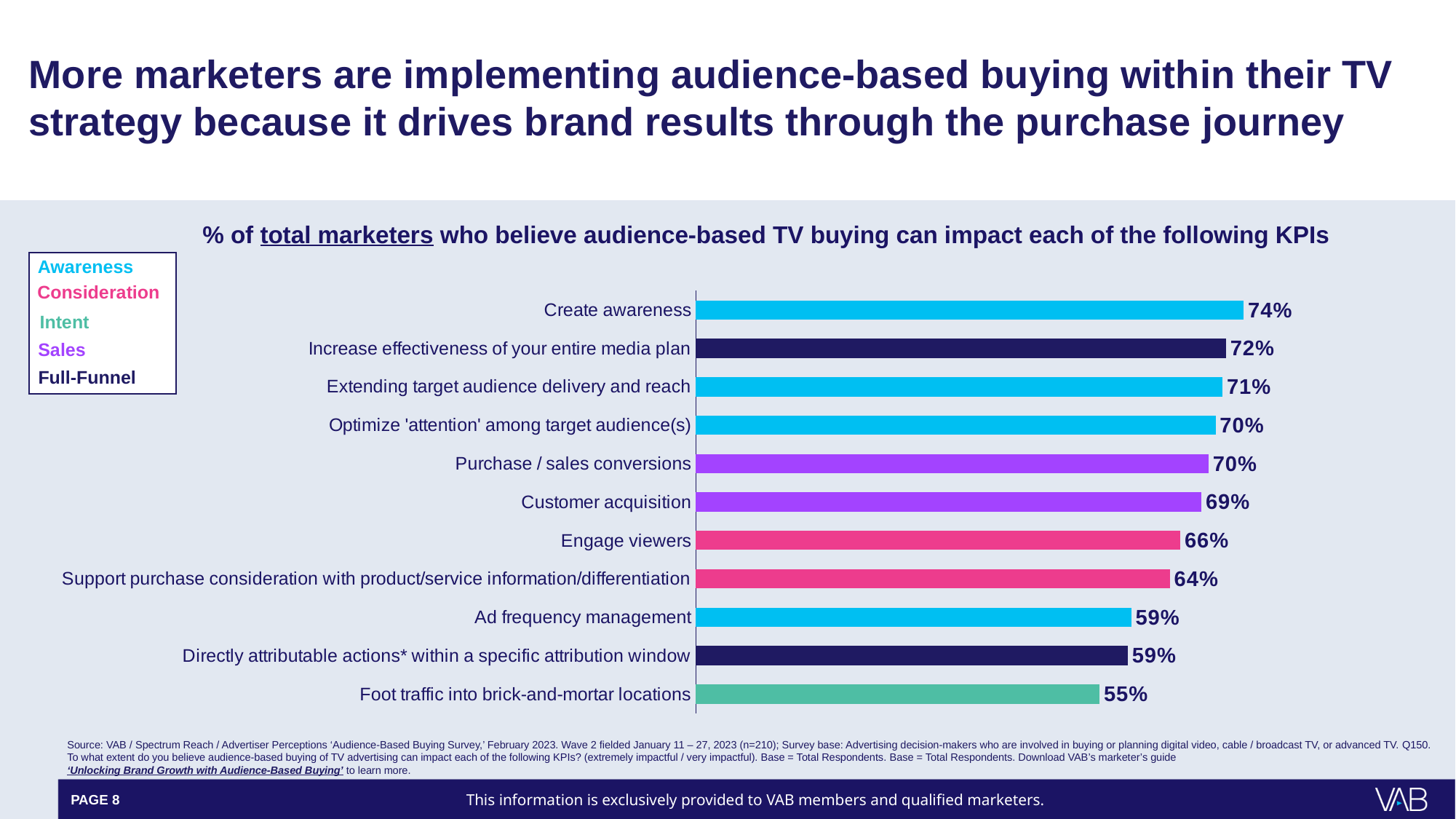
What is the difference between 'Engage viewers' and 'Support purchase consideration with product/service information/differentiation'? 2 percentage points What kind of chart is shown on the slide? Bar chart Which KPI has the lowest percentage of marketers? Foot traffic into brick-and-mortar locations Which funnel stage does the colour of the 'Purchase / sales conversions' bar correspond to in the legend? Sales Which KPI has the highest percentage of marketers? Create awareness What is the value for 'Customer acquisition'? 69% Which is larger: 'Increase effectiveness of your entire media plan' or 'Ad frequency management'? Increase effectiveness of your entire media plan How many funnel stages are listed in the legend? 5 What percentage of total marketers believe audience-based TV buying can impact 'Create awareness'? 74% What is the difference between 'Create awareness' and 'Foot traffic into brick-and-mortar locations'? 19 percentage points What is the value for 'Foot traffic into brick-and-mortar locations'? 55% How many KPIs are shown in the chart? 11